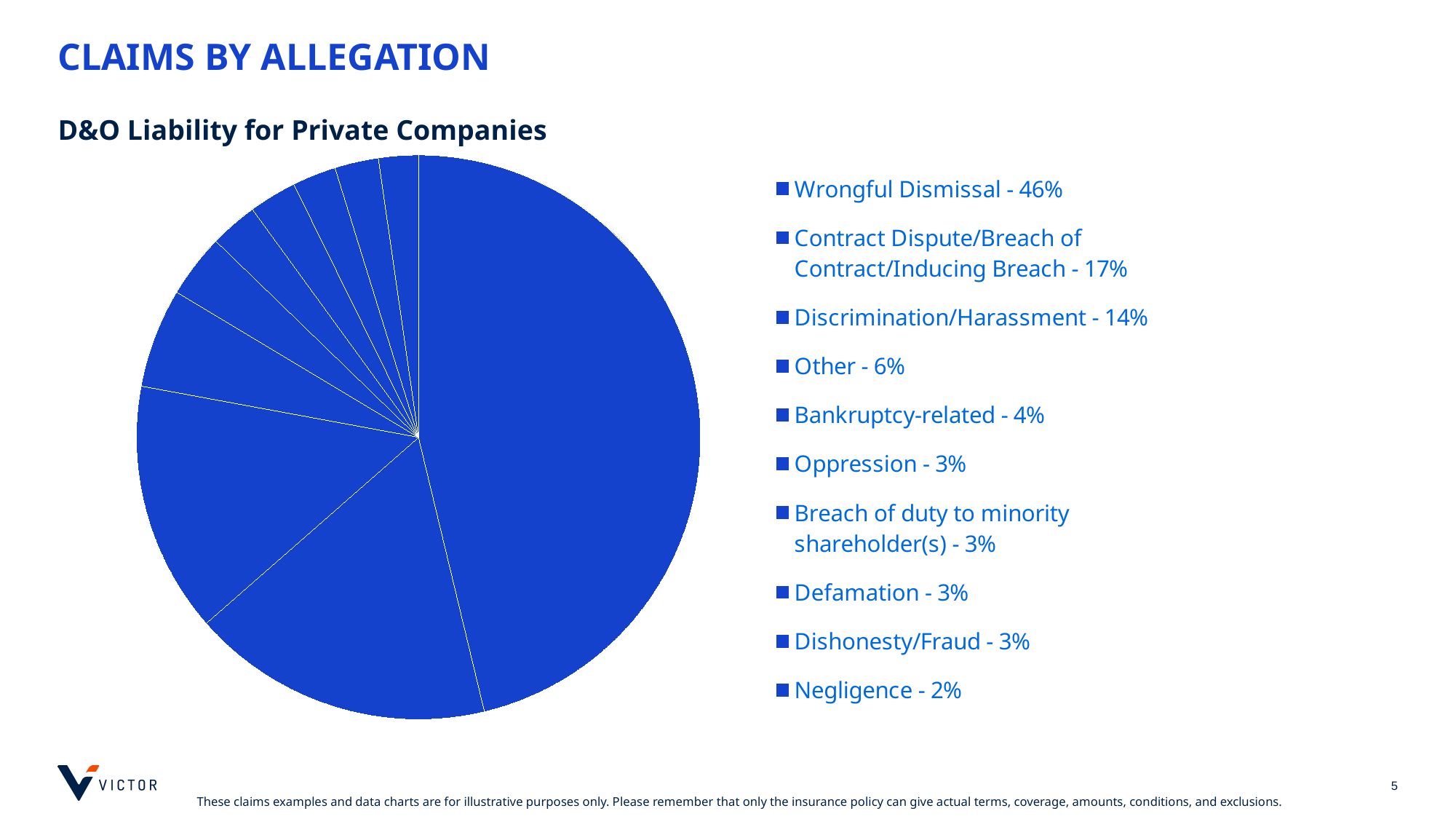
How many allegation categories does the legend list? 10 What share of claims is attributed to Wrongful Dismissal? 46% What is the subtitle shown above the pie chart? D&O Liability for Private Companies What percentage of claims is Bankruptcy-related? 4% What is the difference in percentage points between Wrongful Dismissal and Contract Dispute/Breach of Contract/Inducing Breach? 29 Which allegation category has the largest share of claims? Wrongful Dismissal What is the combined share of Discrimination/Harassment and Other? 20% What percentage of claims is Contract Dispute/Breach of Contract/Inducing Breach? 17% What type of chart is shown on the slide? Pie chart Which is larger: the share for Other or the share for Bankruptcy-related? Other What percentage of claims is Discrimination/Harassment? 14% Which allegation category has the smallest share of claims? Negligence